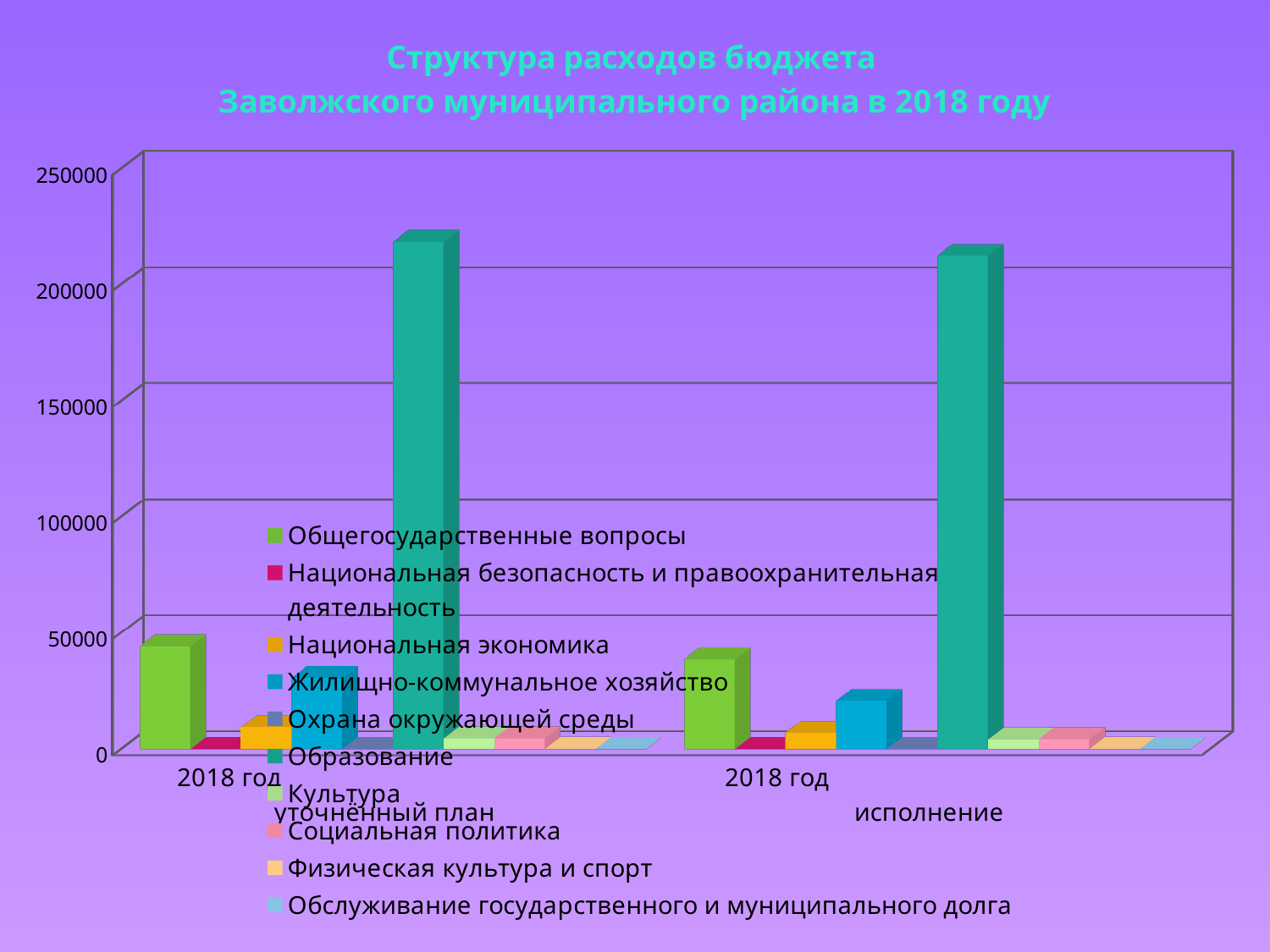
Which series has the highest value in the '2018 год исполнение' group? Образование How many category groups are shown on the x axis? 2 How many series does the legend list? 10 Is the value for Образование in the '2018 год исполнение' group greater or less than 150000? greater Is the value for Общегосударственные вопросы in the '2018 год исполнение' group greater or less than 100000? less Which series has the highest value in the '2018 год уточнённый план' group? Образование Which is larger for Образование: the '2018 год уточнённый план' value or the '2018 год исполнение' value? 2018 год уточнённый план What kind of chart is shown on the slide? bar chart Is the value for Образование in the '2018 год уточнённый план' group greater or less than 150000? greater What is the highest value shown on the vertical axis? 250000 In the '2018 год уточнённый план' group, which is larger: Общегосударственные вопросы or Жилищно-коммунальное хозяйство? Общегосударственные вопросы What is the title of the chart? Структура расходов бюджета Заволжского муниципального района в 2018 году